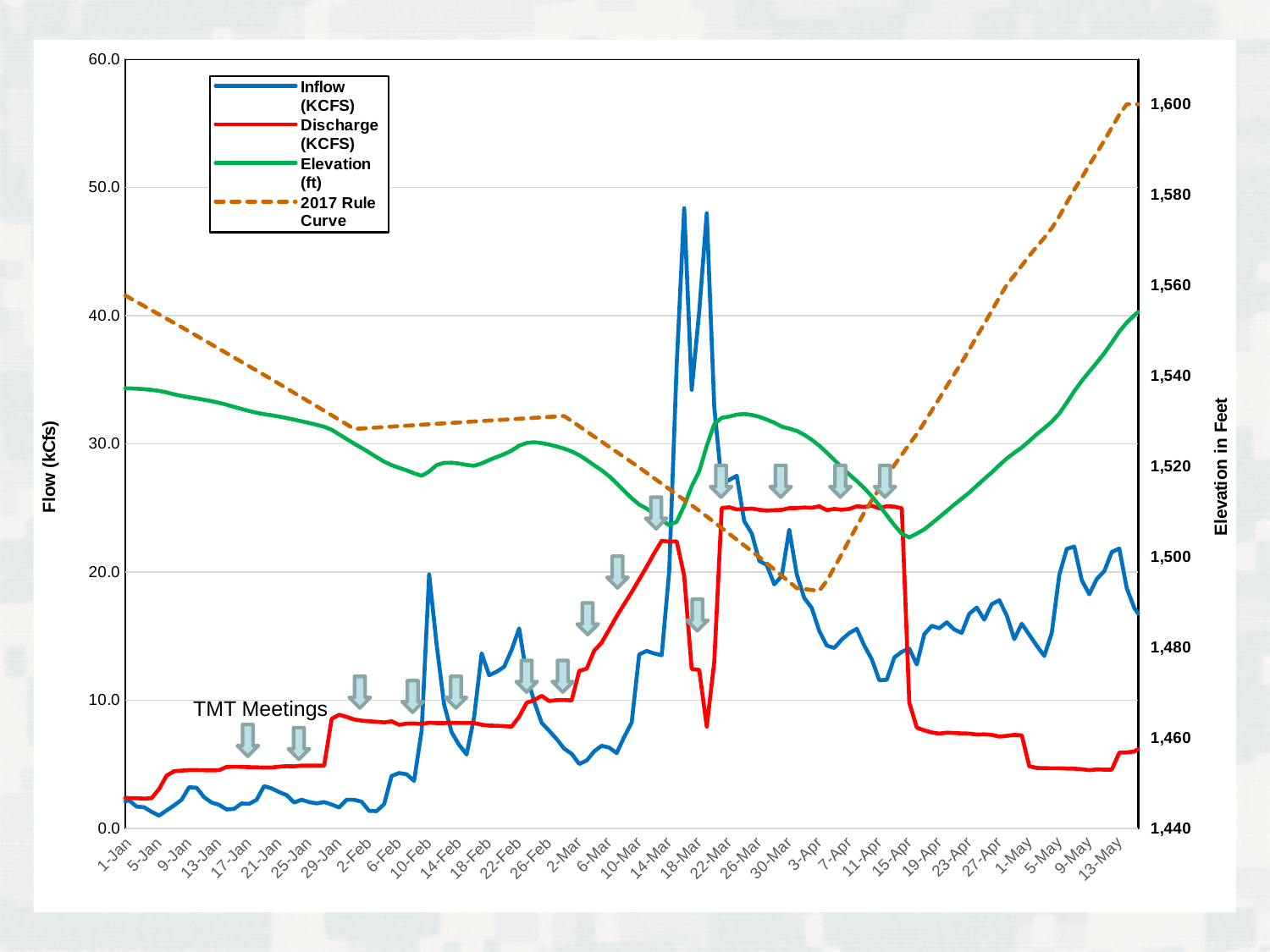
Which is larger on 1-Apr, Inflow (KCFS) or Discharge (KCFS)? Discharge (KCFS) How many series does the legend list? 4 What is the title of the right-hand vertical axis? Elevation in Feet Is the Discharge (KCFS) value on 1-Jan greater or less than 10? less Is the peak value of Inflow (KCFS) in mid-March greater or less than 40? greater Does the 2017 Rule Curve rise or fall between 3-Apr and 13-May? rise Does the Elevation (ft) line rise or fall between 1-Jan and 6-Feb? fall Which series is drawn as a dashed line? 2017 Rule Curve Is the 2017 Rule Curve value on 1-Jan greater or less than 1,540? greater What kind of chart is shown on the slide? line chart